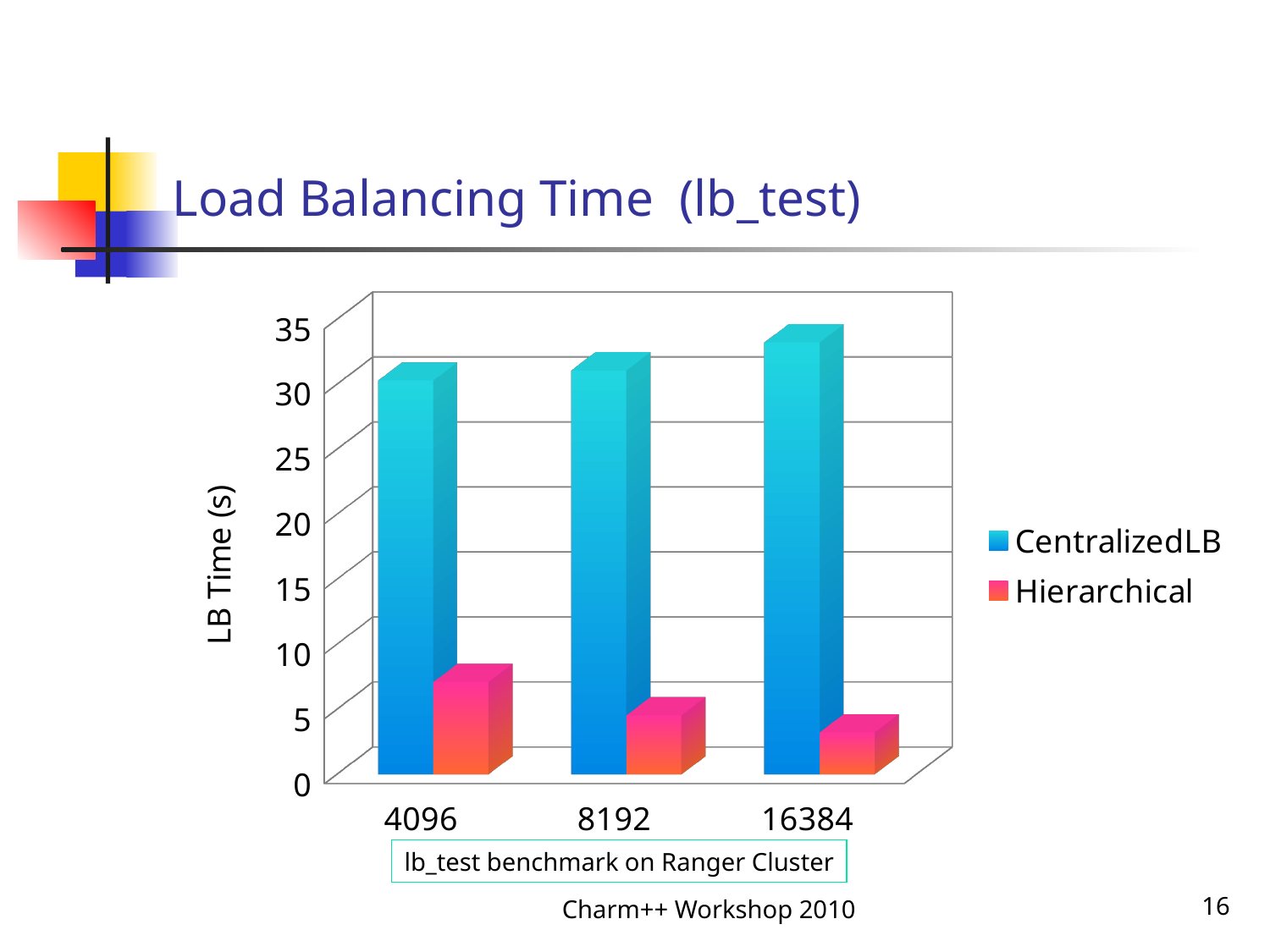
Is the Hierarchical value for 4096 greater or less than 10? less For which category is the Hierarchical value lowest? 16384 How many categories are shown on the x axis? 3 What is the label of the y axis? LB Time (s) For which category is the Hierarchical value highest? 4096 How many series does the legend list? 2 Is the CentralizedLB value for 4096 greater or less than 25? greater For which category is the CentralizedLB value highest? 16384 Which is larger at 8192, the CentralizedLB value or the Hierarchical value? CentralizedLB Do the Hierarchical values rise or fall as the number of processors increases along the x axis? fall What kind of chart is shown on the slide? bar chart Which series is shown in pink/red? Hierarchical